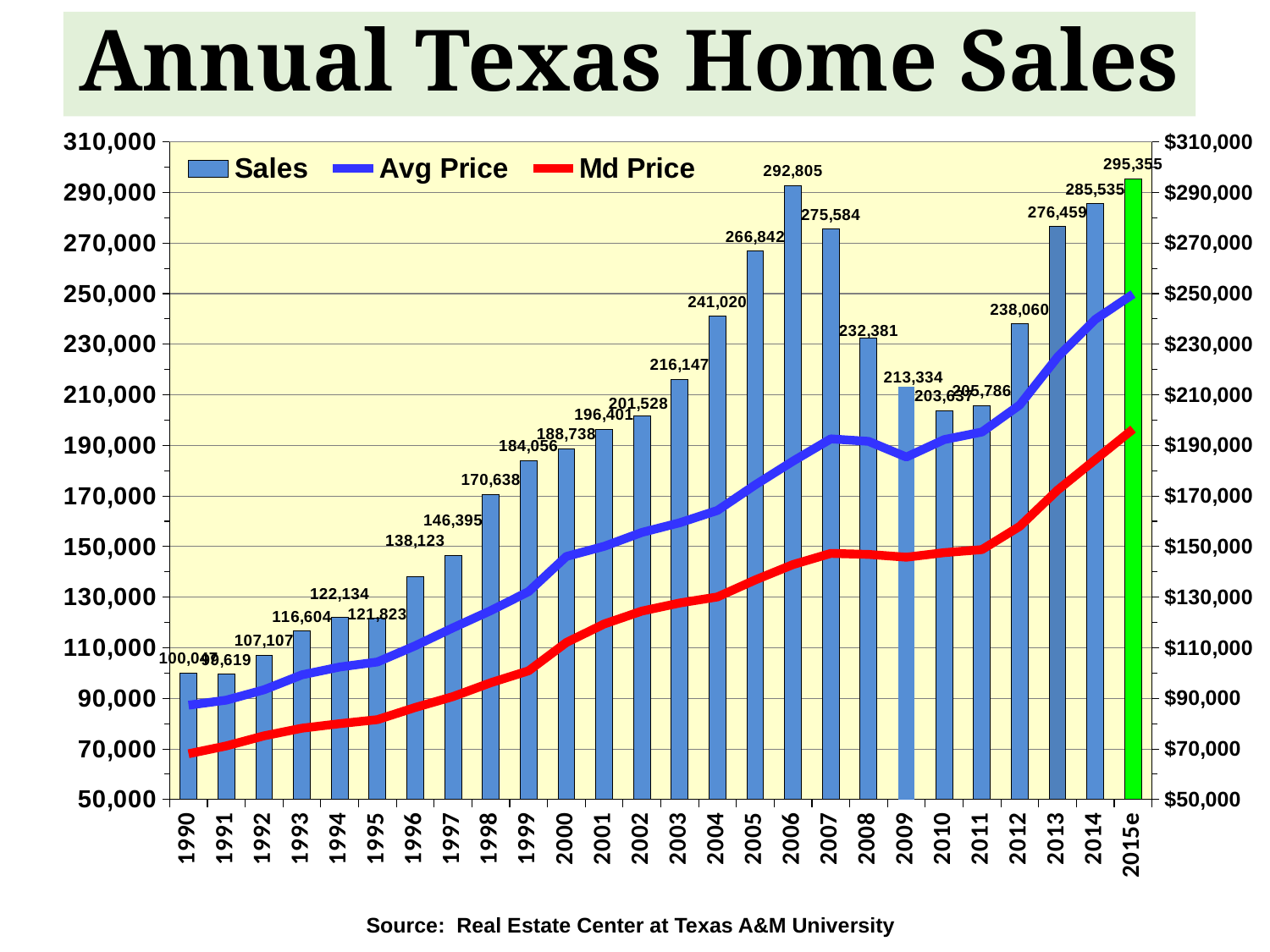
What was the Sales value for 2006? 292,805 What colour is the bar for 2015e? Green Which year had higher Sales, 2005 or 2013? 2013 What is the difference in Sales between 2015e and 2014? 9,820 What kind of chart is shown on the slide? A bar chart combined with line charts How many series does the legend list? 3 What was the Sales value for 2014? 285,535 What was the Sales value for 2003? 216,147 Which year has the highest Sales value? 2015e Is the Avg Price for 2015e greater or less than $230,000? greater What is the difference in Sales between 2006 and 2007? 17,221 Does the Md Price line generally rise or fall from 1990 to 2015e? Rise